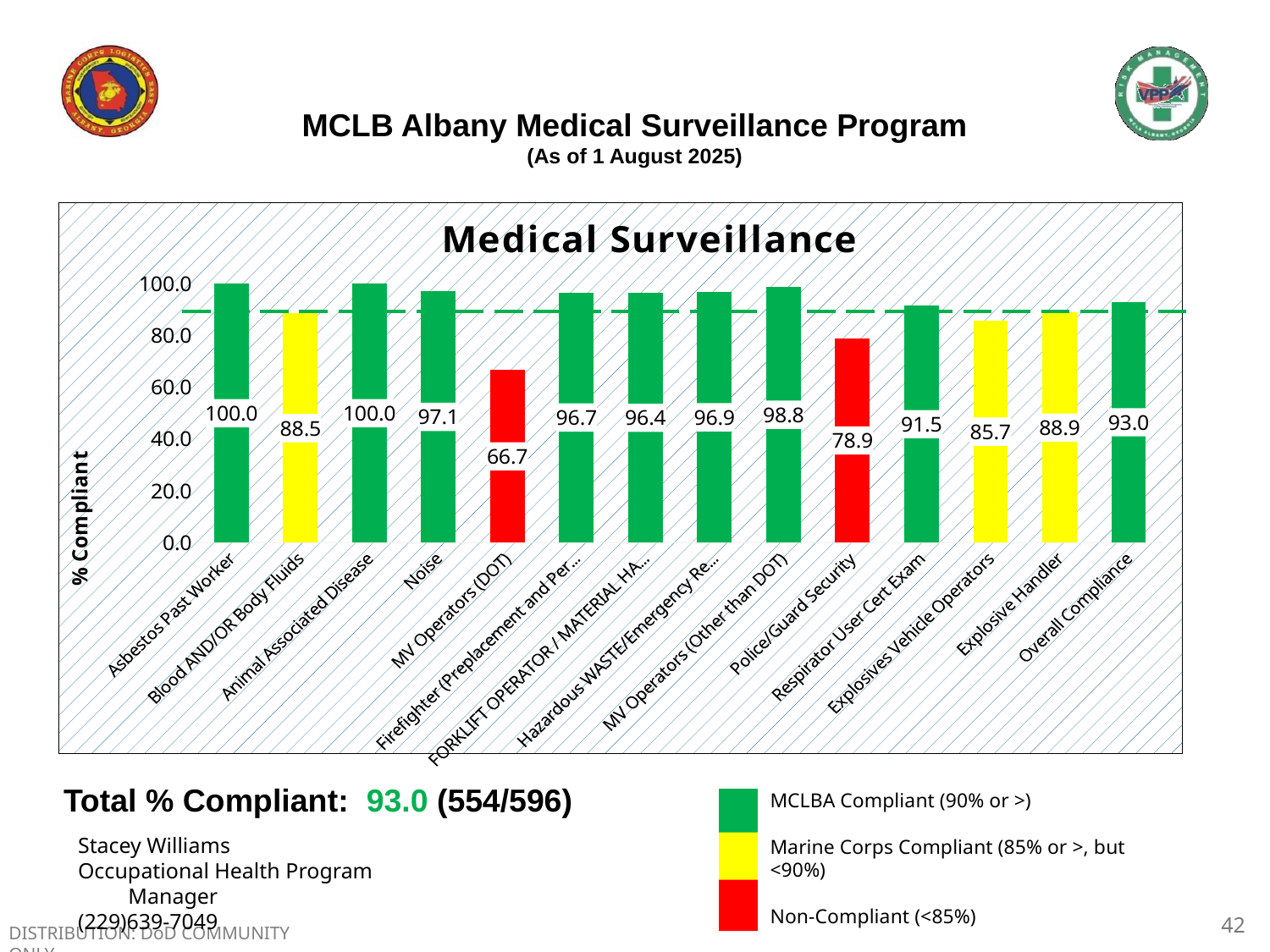
What kind of chart is this? bar chart What is the value for Noise? 97.1 What is the difference between the values for Explosive Handler and Explosives Vehicle Operators? 3.2 What is the value for Respirator User Cert Exam? 91.5 Which category has the lowest value? MV Operators (DOT) What is the title of the chart? Medical Surveillance Which is larger, the value for Blood AND/OR Body Fluids or the value for Noise? Noise What is the value for Overall Compliance? 93.0 What is the difference between the values for Asbestos Past Worker and MV Operators (DOT)? 33.3 How many categories are shown on the x axis? 14 What is the value for Police/Guard Security? 78.9 Is the value for Police/Guard Security greater or less than 80.0? less